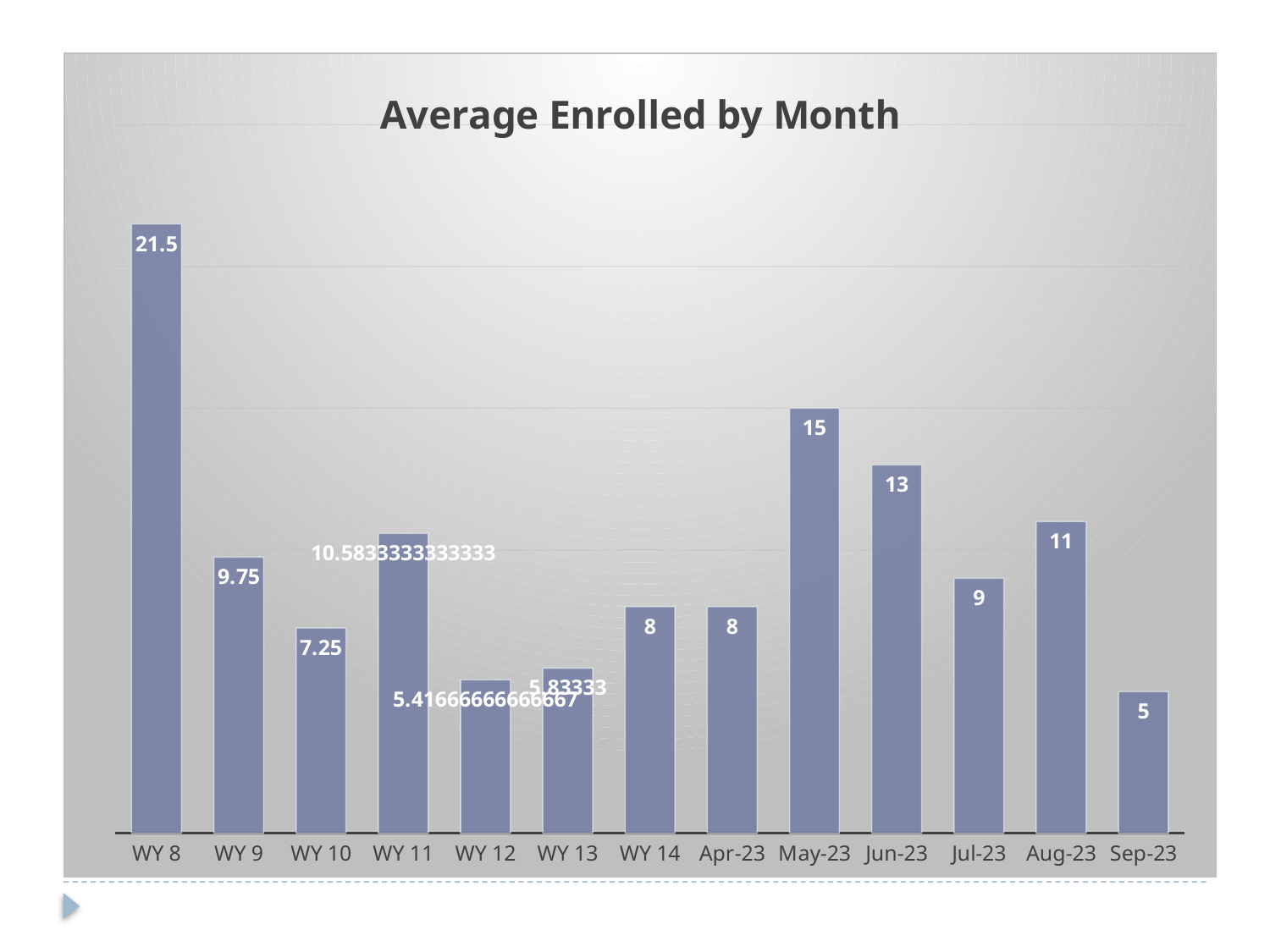
What is the value for May-23? 15 What is the difference between the values for WY 8 and WY 9? 11.75 What is the value for Sep-23? 5 What is the value for WY 9? 9.75 How many categories are shown on the x axis? 13 What is the title of the chart? Average Enrolled by Month Which category has the highest value? WY 8 Which is larger, the value for Jun-23 or the value for Aug-23? Jun-23 What is the value for WY 8? 21.5 What is the difference between the values for May-23 and Jun-23? 2 What kind of chart is this? bar chart Which category has the lowest value? Sep-23